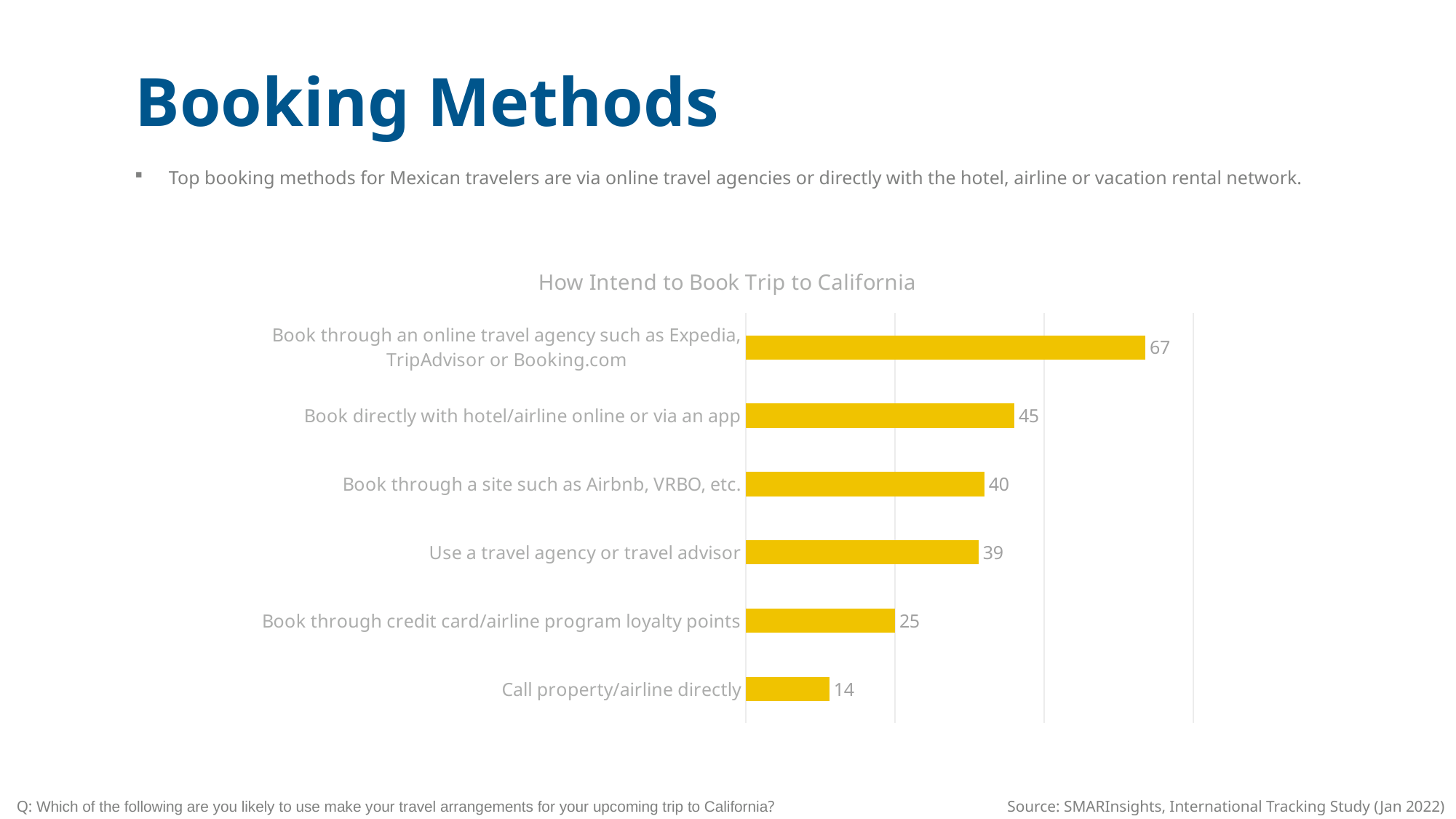
What is the value for 'Book through credit card/airline program loyalty points'? 25 What is the difference between the value for booking through an online travel agency and booking directly with hotel/airline online or via an app? 22 What is the value for 'Use a travel agency or travel advisor'? 39 How many booking methods are shown in the chart? 6 What is the value for 'Book directly with hotel/airline online or via an app'? 45 Which booking method has the highest value? Book through an online travel agency such as Expedia, TripAdvisor or Booking.com What is the value for 'Call property/airline directly'? 14 What kind of chart is shown on the slide? Bar chart What is the title of the chart? How Intend to Book Trip to California Which is larger: the value for 'Book through a site such as Airbnb, VRBO, etc.' or 'Book through credit card/airline program loyalty points'? Book through a site such as Airbnb, VRBO, etc. What colour are the bars in the chart? Yellow Which booking method has the lowest value? Call property/airline directly